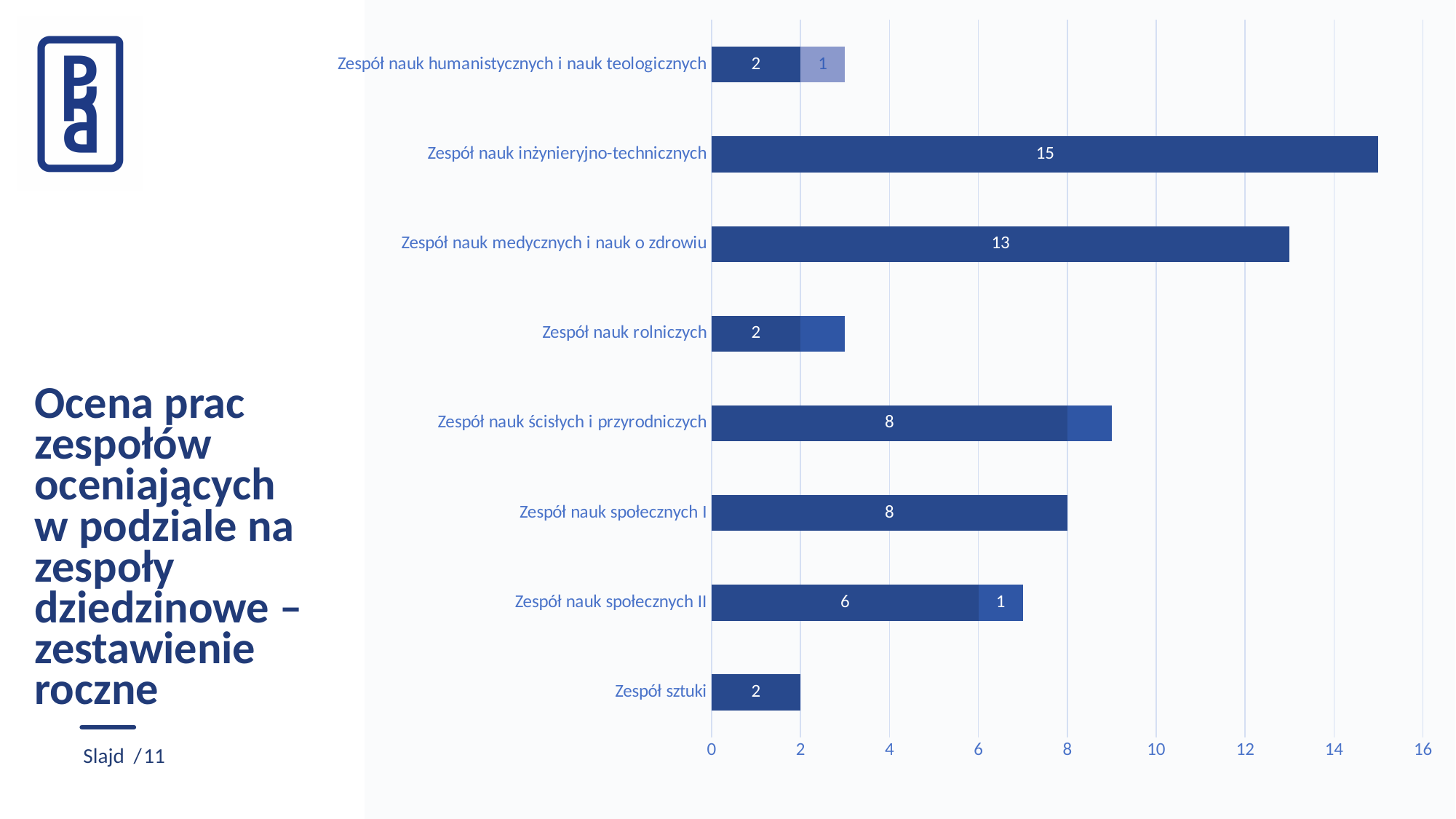
Is the total bar length for Zespół nauk ścisłych i przyrodniczych greater or less than 10? less What is the difference between the dark blue segment values for Zespół nauk inżynieryjno-technicznych and Zespół nauk medycznych i nauk o zdrowiu? 2 What is the labelled value of the dark blue segment for Zespół nauk medycznych i nauk o zdrowiu? 13 What is the total of the labelled segments for Zespół nauk humanistycznych i nauk teologicznych? 3 What kind of chart is shown on the slide? bar chart What is the labelled value of the lighter segment for Zespół nauk humanistycznych i nauk teologicznych? 1 How many categories are shown in the chart? 8 What is the labelled value of the dark blue segment for Zespół nauk społecznych II? 6 Which has a larger dark blue segment value: Zespół nauk społecznych I or Zespół nauk społecznych II? Zespół nauk społecznych I What is the total of the labelled segments for Zespół nauk społecznych II? 7 Which category has the longest bar in the chart? Zespół nauk inżynieryjno-technicznych What is the labelled value of the dark blue segment for Zespół nauk inżynieryjno-technicznych? 15